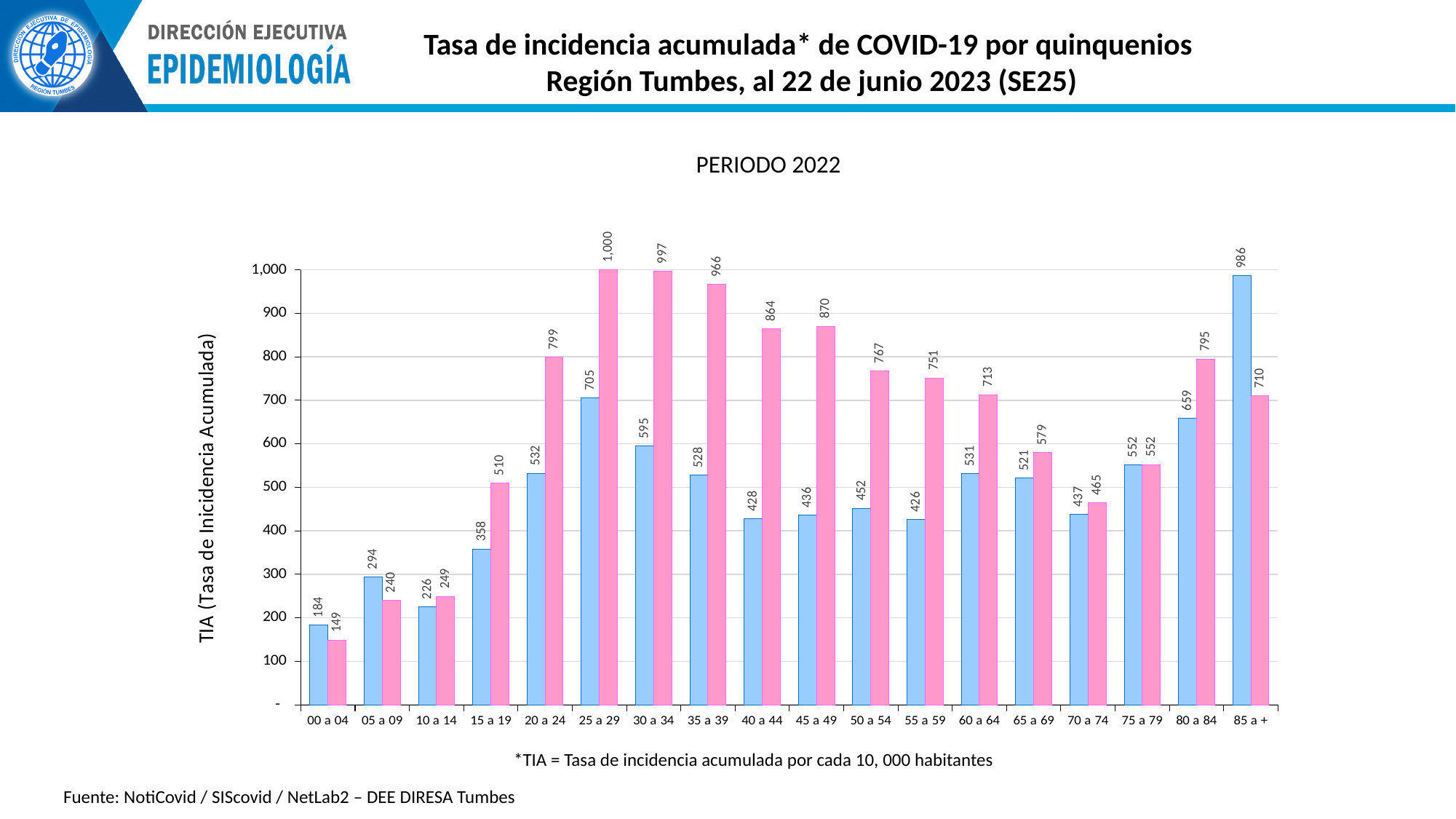
How many age groups are shown on the x axis? 18 Which age group has the highest pink bar? 25 a 29 What kind of chart is shown on the slide? bar chart What is the value of the pink bar for the 40 a 44 age group? 864 What is the difference between the pink and blue bars for the 20 a 24 age group? 267 Is the value of the pink bar for the 35 a 39 age group greater or less than 900? greater Which age group has the highest blue bar? 85 a + What is the value of the pink bar for the 00 a 04 age group? 149 Which age group has the lowest blue bar? 00 a 04 For the 85 a + age group, which bar is larger, the blue or the pink? blue What is the title shown above the chart? PERIODO 2022 What is the value of the blue bar for the 25 a 29 age group? 705